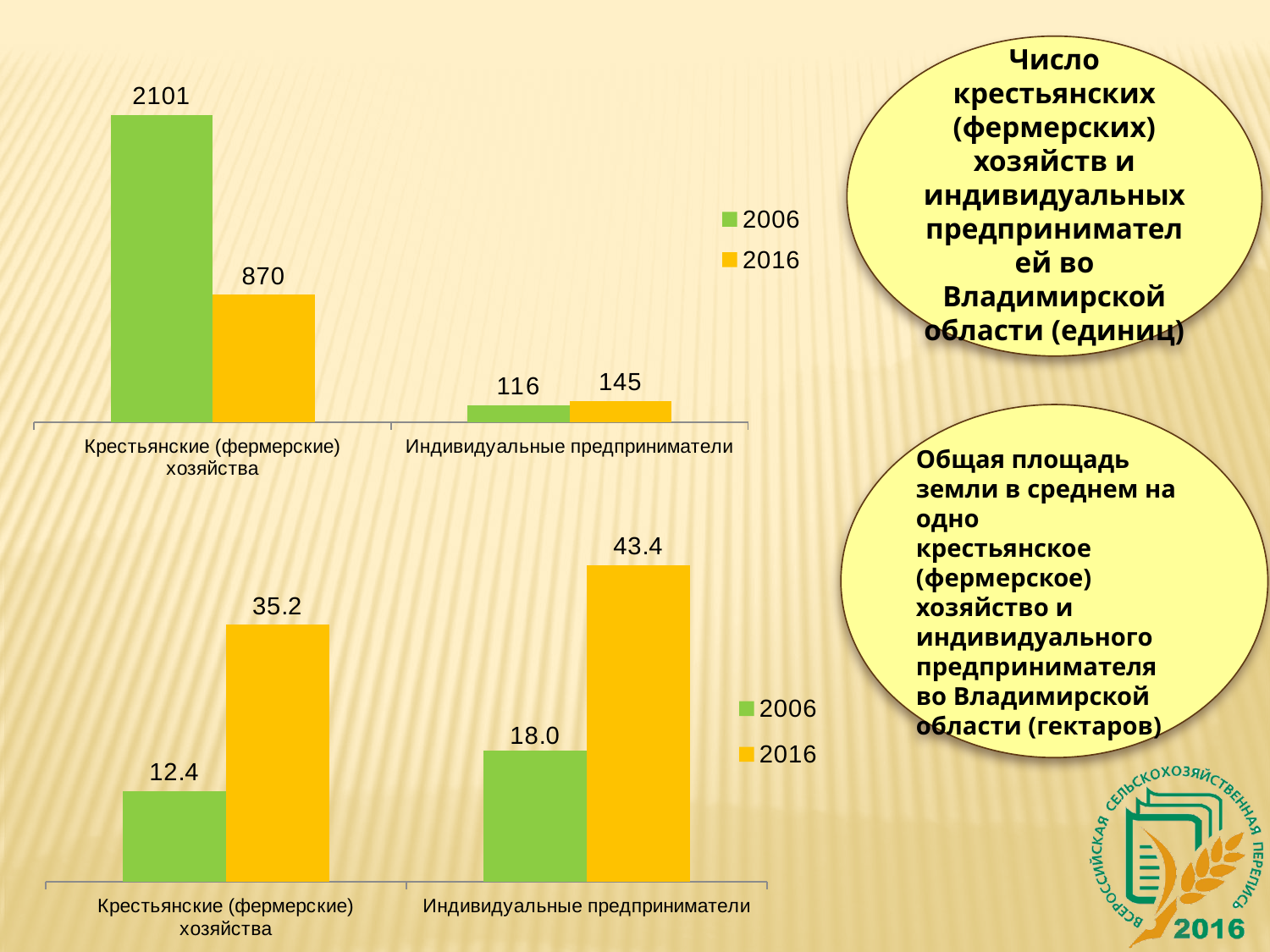
What type of chart is the bottom chart? Bar chart In the bottom chart, what is the value for Индивидуальные предприниматели in 2016? 43.4 In the top chart, what is the value for Крестьянские (фермерские) хозяйства in 2006? 2101 In the bottom chart, what is the difference between the 2016 and 2006 values for Крестьянские (фермерские) хозяйства? 22.8 How many categories are shown on the x axis of the top chart? 2 In the top chart, what is the value for Индивидуальные предприниматели in 2016? 145 In the top chart, which bar is the highest? Крестьянские (фермерские) хозяйства, 2006 How many series does the legend of the bottom chart list? 2 In the bottom chart, which bar is the lowest? Крестьянские (фермерские) хозяйства, 2006 In the top chart, what is the difference between the 2006 and 2016 values for Крестьянские (фермерские) хозяйства? 1231 In the top chart, which is larger for Индивидуальные предприниматели: the 2006 value or the 2016 value? 2016 In the bottom chart, what is the value for Крестьянские (фермерские) хозяйства in 2006? 12.4